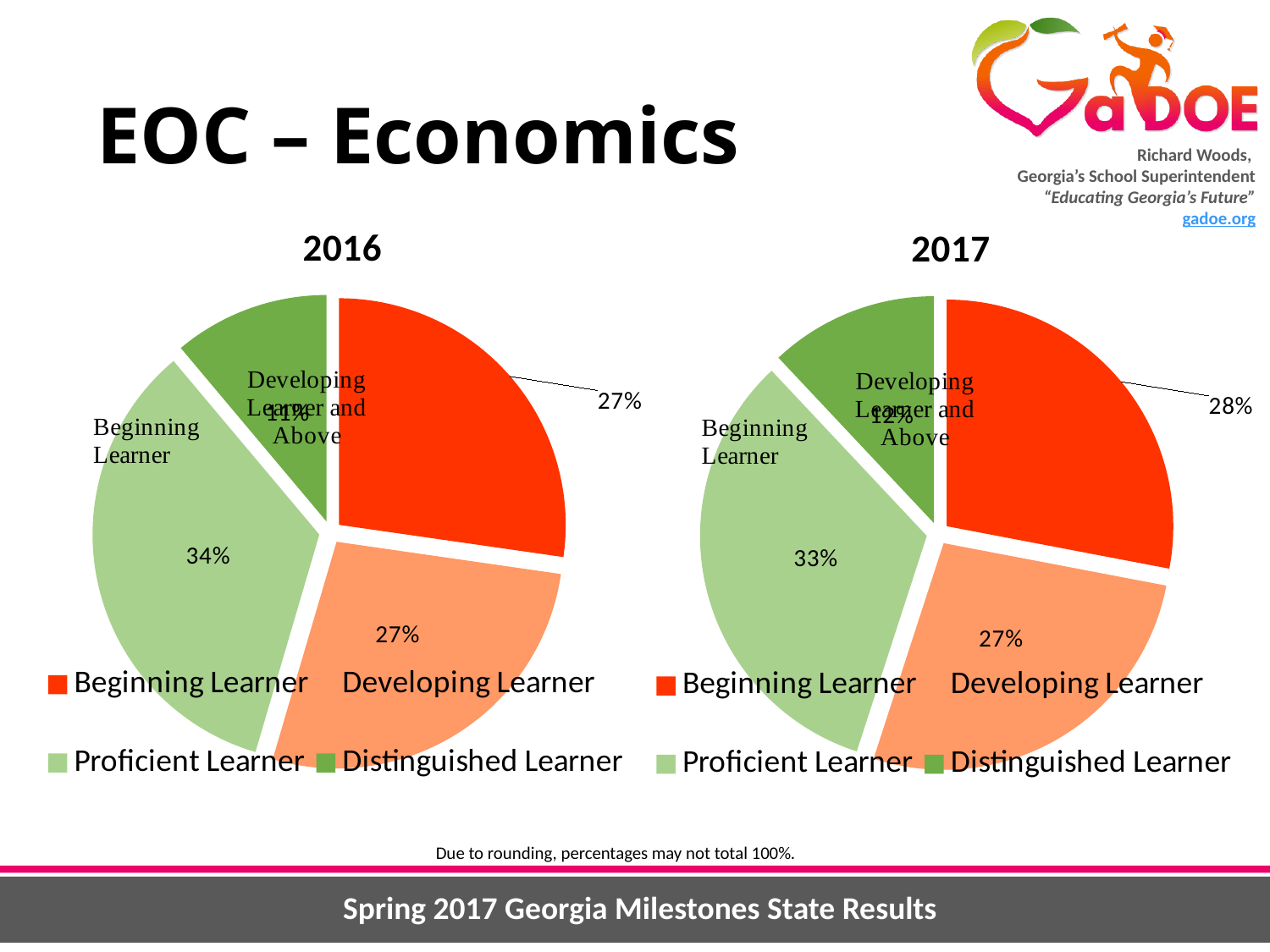
In the 2017 chart, what percentage of students were Distinguished Learners? 12% What type of chart is used to show the 2017 results? Pie chart In the 2017 chart, which achievement level has the smallest share? Distinguished Learner How many achievement levels does the legend of the 2016 chart list? 4 In the 2016 chart, what percentage of students were Developing Learners? 27% In the 2017 chart, what is the difference between the Proficient Learner share and the Distinguished Learner share? 21% Which is larger: the Beginning Learner share in 2017 or the Distinguished Learner share in 2017? Beginning Learner share in 2017 In the 2016 chart, which achievement level has the largest share? Proficient Learner In the 2017 chart, what percentage of students were Beginning Learners? 28% What colour represents Beginning Learner in the charts? Red-orange What is the difference between the Proficient Learner share in 2016 and in 2017? 1% In the 2016 chart, what percentage of students were Proficient Learners? 34%